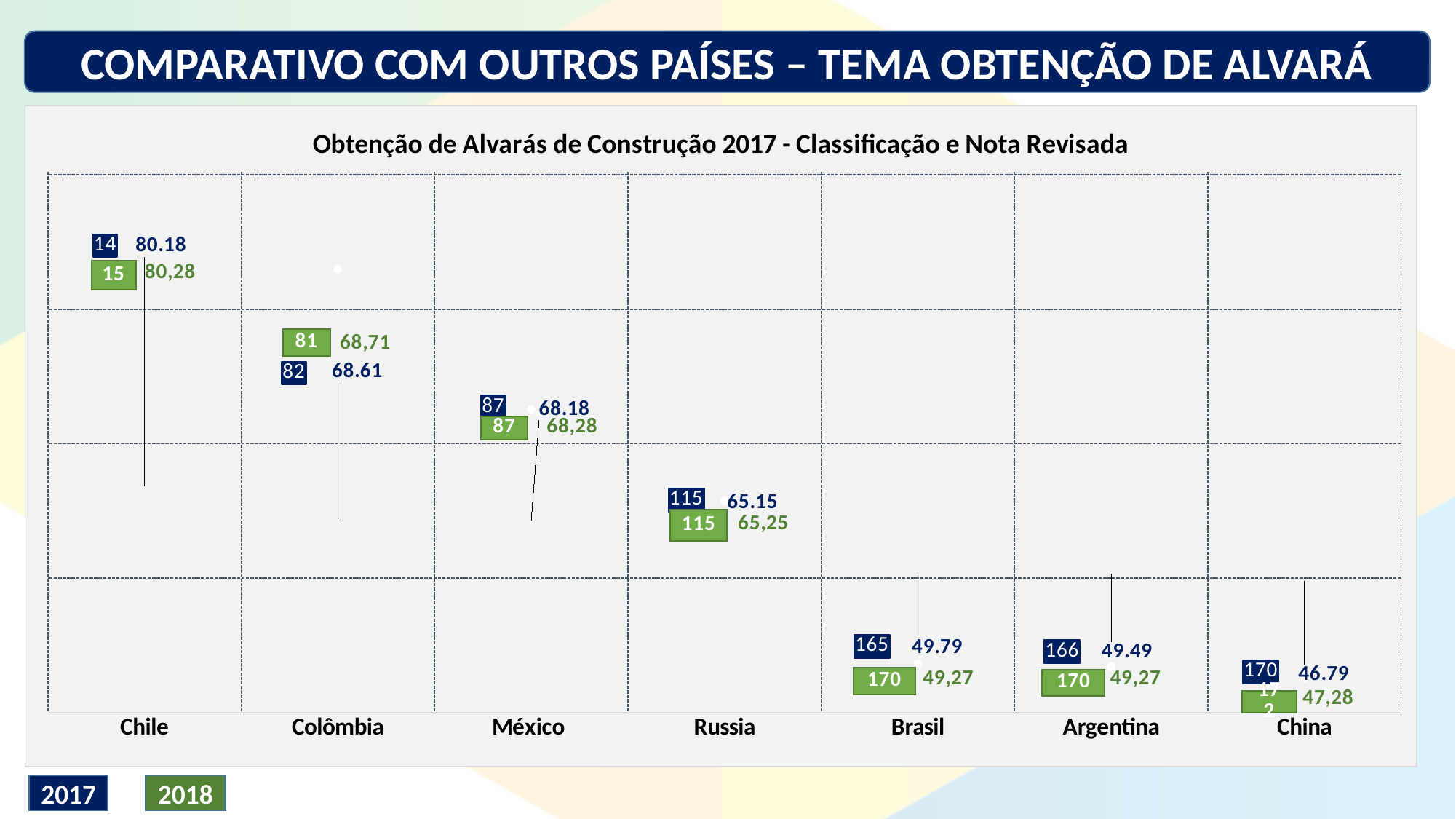
What ranking position is shown for Russia in 2017? 115 Which is larger, México's 2017 score or Russia's 2017 score? México's 2017 score What is the 2018 score shown for Colômbia? 68,71 What is the 2017 score shown for Chile? 80.18 Which country has the highest 2018 score? Chile What is the 2018 score shown for Brasil? 49,27 Do the scores rise or fall moving from Chile on the left to China on the right? fall What is the difference between Brasil's 2018 ranking (170) and its 2017 ranking (165)? 5 How many countries are shown on the x axis? 7 Which country has the lowest 2017 score? China What ranking position is shown for Argentina in 2018? 170 How many series does the legend list? 2